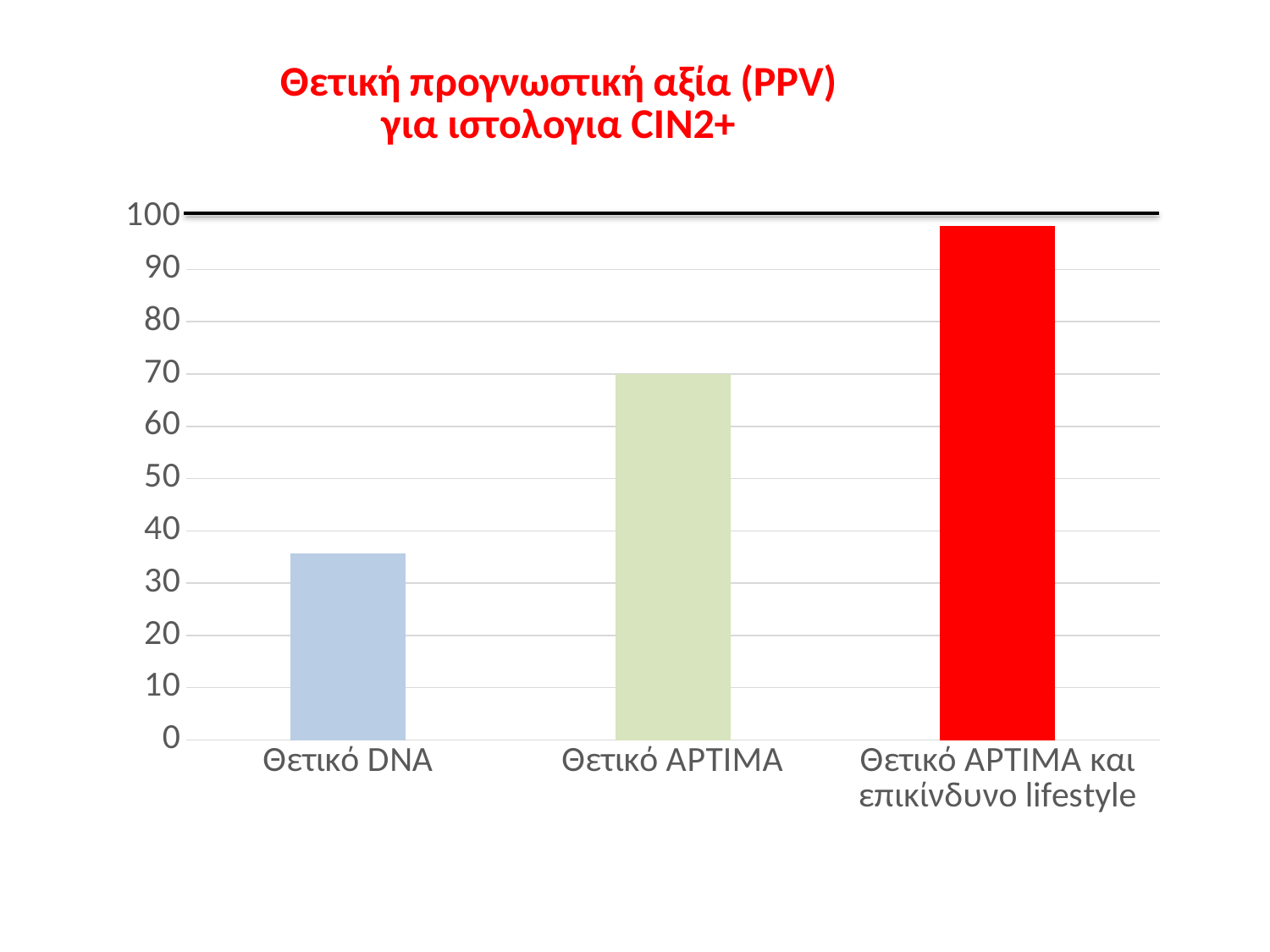
Which category has the lowest value? Θετικό DNA Is the value for Θετικό DNA greater or less than 40? less What is the title of the chart? Θετική προγνωστική αξία (PPV) για ιστολογια CIN2+ Which is larger, the value for Θετικό APTIMA or the value for Θετικό DNA? Θετικό APTIMA What is the value for Θετικό APTIMA? 70 Do the values rise or fall from left to right across the categories? rise How many categories are plotted in the chart? 3 What kind of chart is shown on the slide? bar chart Is the value for Θετικό APTIMA greater or less than 60? greater Is the value for Θετικό APTIMA και επικίνδυνο lifestyle greater or less than 90? greater Which category has the highest value? Θετικό APTIMA και επικίνδυνο lifestyle